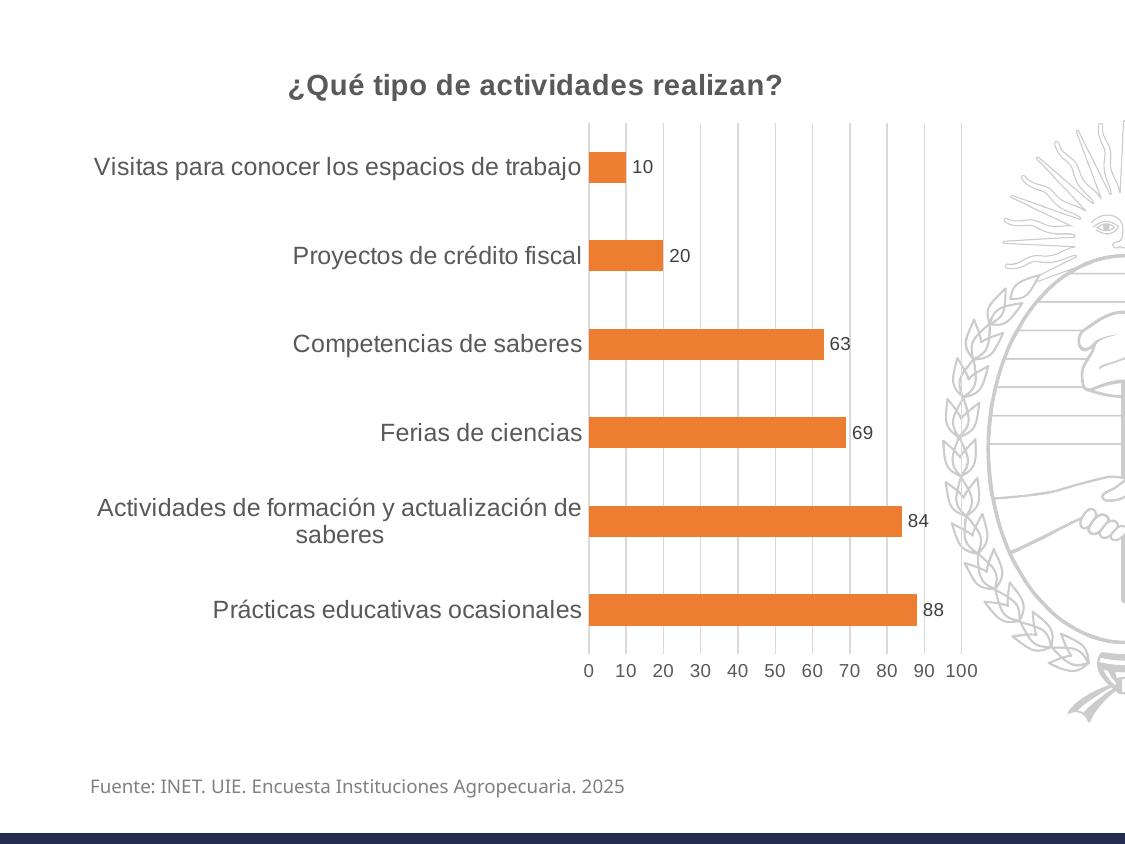
What is the value for Actividades de formación y actualización de saberes? 84 What is the difference between the values for Prácticas educativas ocasionales and Visitas para conocer los espacios de trabajo? 78 Which is larger, the value for Ferias de ciencias or the value for Proyectos de crédito fiscal? Ferias de ciencias What is the value for Proyectos de crédito fiscal? 20 How many categories are shown in the chart? 6 What is the value for Prácticas educativas ocasionales? 88 What kind of chart is shown on the slide? Bar chart Which category has the lowest value? Visitas para conocer los espacios de trabajo What is the title of the chart? ¿Qué tipo de actividades realizan? What is the difference between the values for Ferias de ciencias and Competencias de saberes? 6 Which category has the highest value? Prácticas educativas ocasionales What is the value for Competencias de saberes? 63